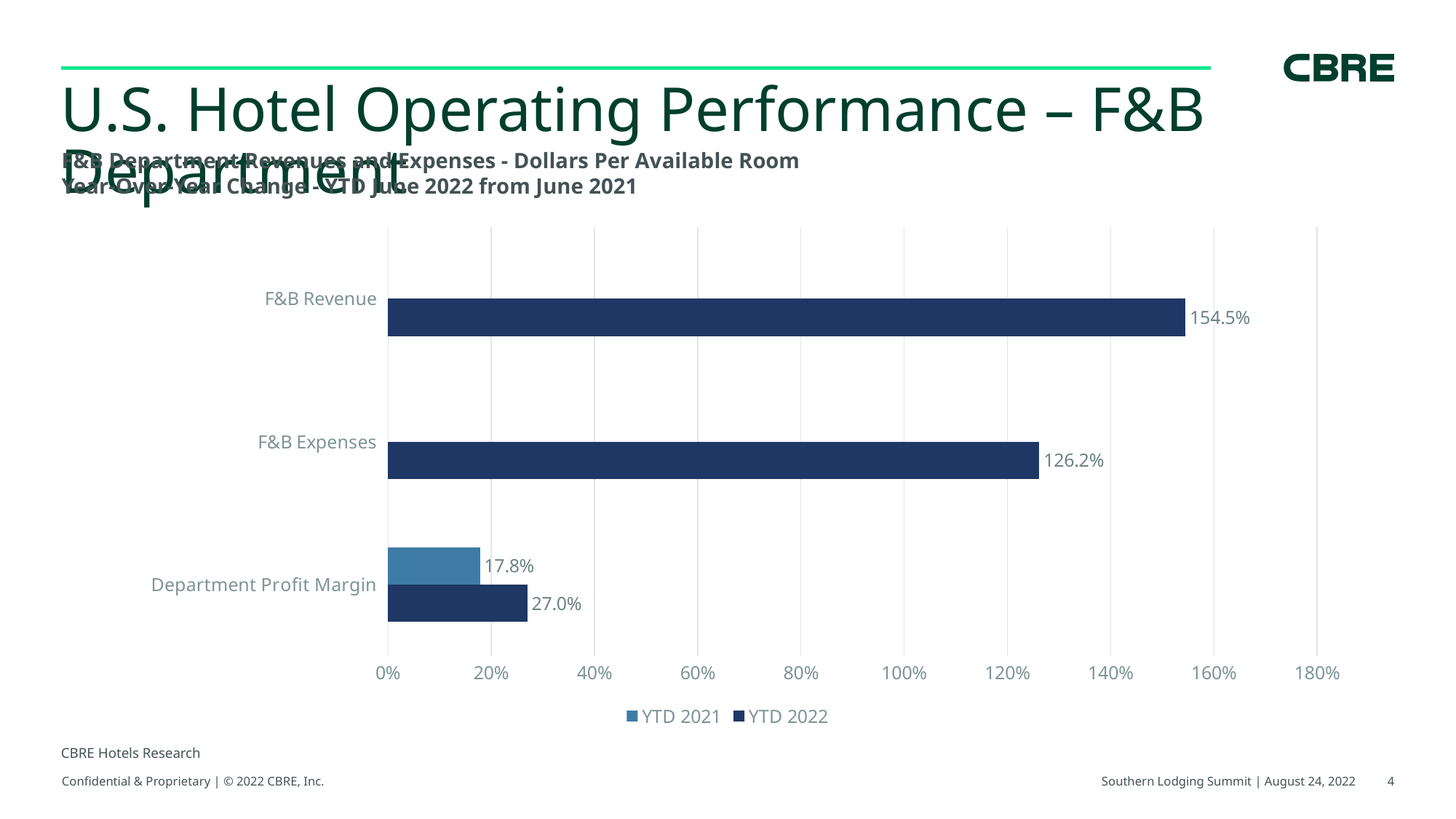
Is the YTD 2022 Department Profit Margin larger or smaller than the YTD 2021 Department Profit Margin? larger What is the YTD 2021 value for Department Profit Margin? 17.8% What is the YTD 2022 value for Department Profit Margin? 27.0% What kind of chart is shown on the slide? bar chart What is the difference between the YTD 2022 values for F&B Revenue and F&B Expenses? 28.3% What is the YTD 2022 value for F&B Revenue? 154.5% Which category has the lowest YTD 2022 value? Department Profit Margin What is the YTD 2022 value for F&B Expenses? 126.2% By how much did the Department Profit Margin change from YTD 2021 to YTD 2022? 9.2% How many series does the legend list? 2 Is the YTD 2022 value for F&B Expenses greater or less than 140%? less Which category has the highest YTD 2022 value? F&B Revenue